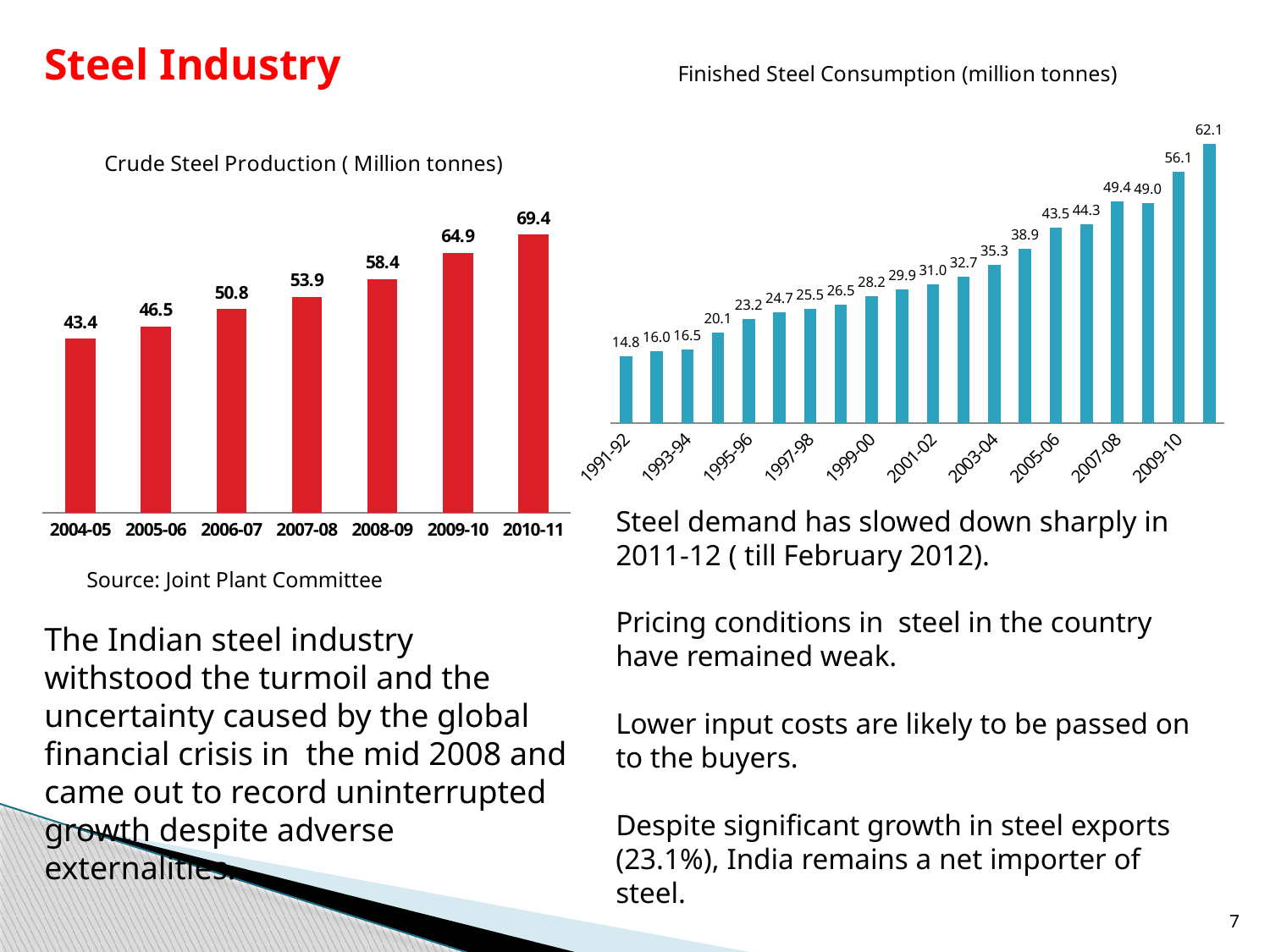
In the Finished Steel Consumption chart, how many bars are plotted? 20 In the Finished Steel Consumption chart, which is larger, the value for 2003-04 or the value for 2007-08? 2007-08 In the Crude Steel Production chart, what is the difference between the values for 2010-11 and 2004-05? 26.0 In the Crude Steel Production chart, what is the value for 2008-09? 58.4 In the Crude Steel Production chart, how many years are shown? 7 In the Crude Steel Production chart, which year has the highest value? 2010-11 In the Crude Steel Production chart, do the values rise or fall from 2004-05 to 2010-11? rise In the Finished Steel Consumption chart, what is the value for 1991-92? 14.8 In the Crude Steel Production chart, which year has the lowest value? 2004-05 In the Finished Steel Consumption chart, what is the highest value shown? 62.1 In the Finished Steel Consumption chart, what is the value for 2005-06? 43.5 What type of chart is the Finished Steel Consumption chart? bar chart